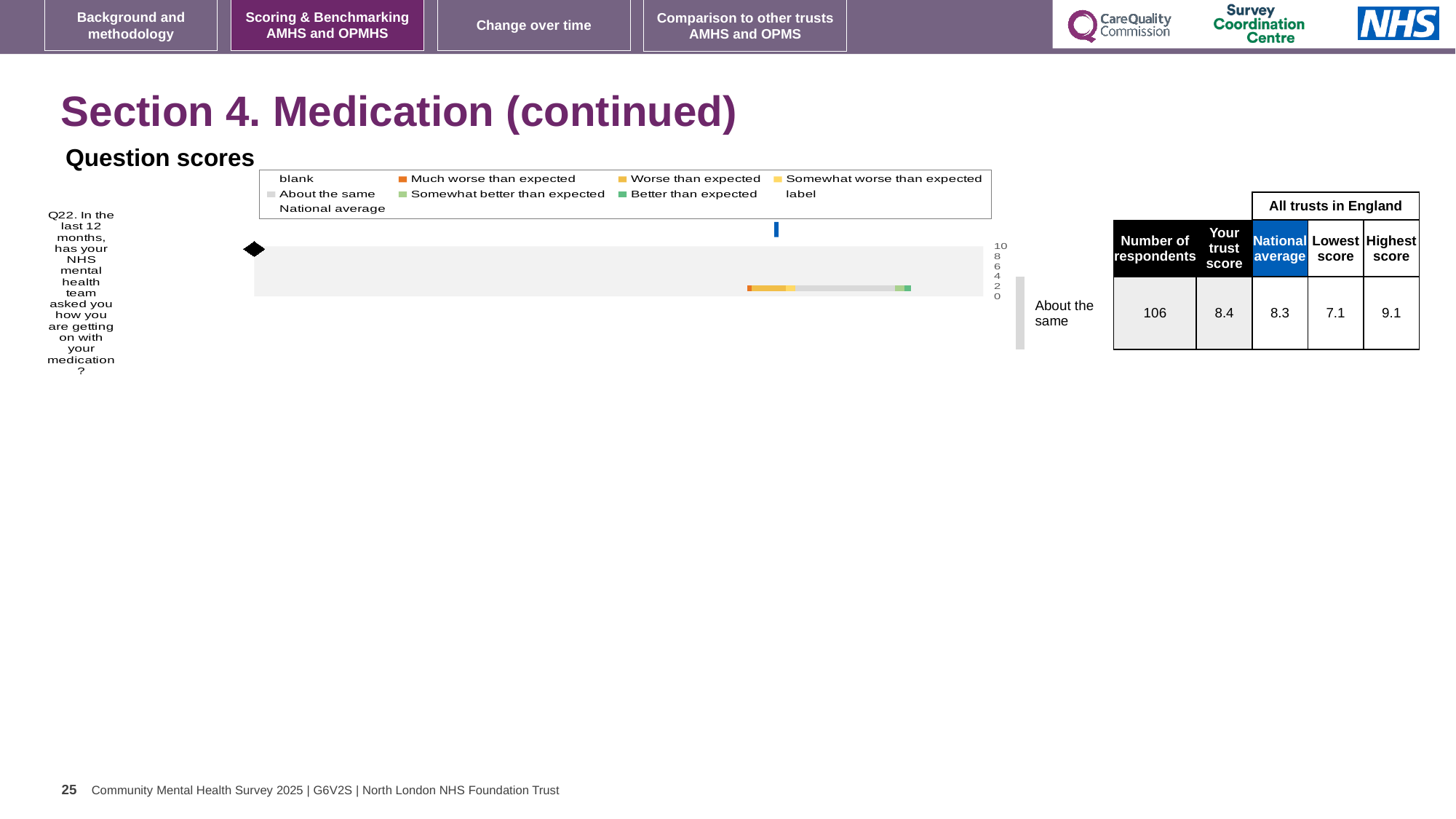
What is the difference between the highest score and the lowest score for Q22 in the table? 2.0 What kind of chart is shown under "Question scores"? bar chart In the table next to the chart, what is the national average for Q22? 8.3 Which is larger for Q22, the trust score or the national average? trust score How many questions (categories) are plotted in the Question scores chart? 1 In the table next to the chart, what is the number of respondents for Q22? 106 In the table next to the chart, what is the highest score among all trusts in England for Q22? 9.1 In the table next to the chart, what is the trust score for Q22? 8.4 What is the highest tick value shown on the axis of the Question scores chart? 10 In the table next to the chart, what is the lowest score among all trusts in England for Q22? 7.1 Which question number is plotted in the Question scores chart? Q22 How many entries does the legend of the Question scores chart list? 9